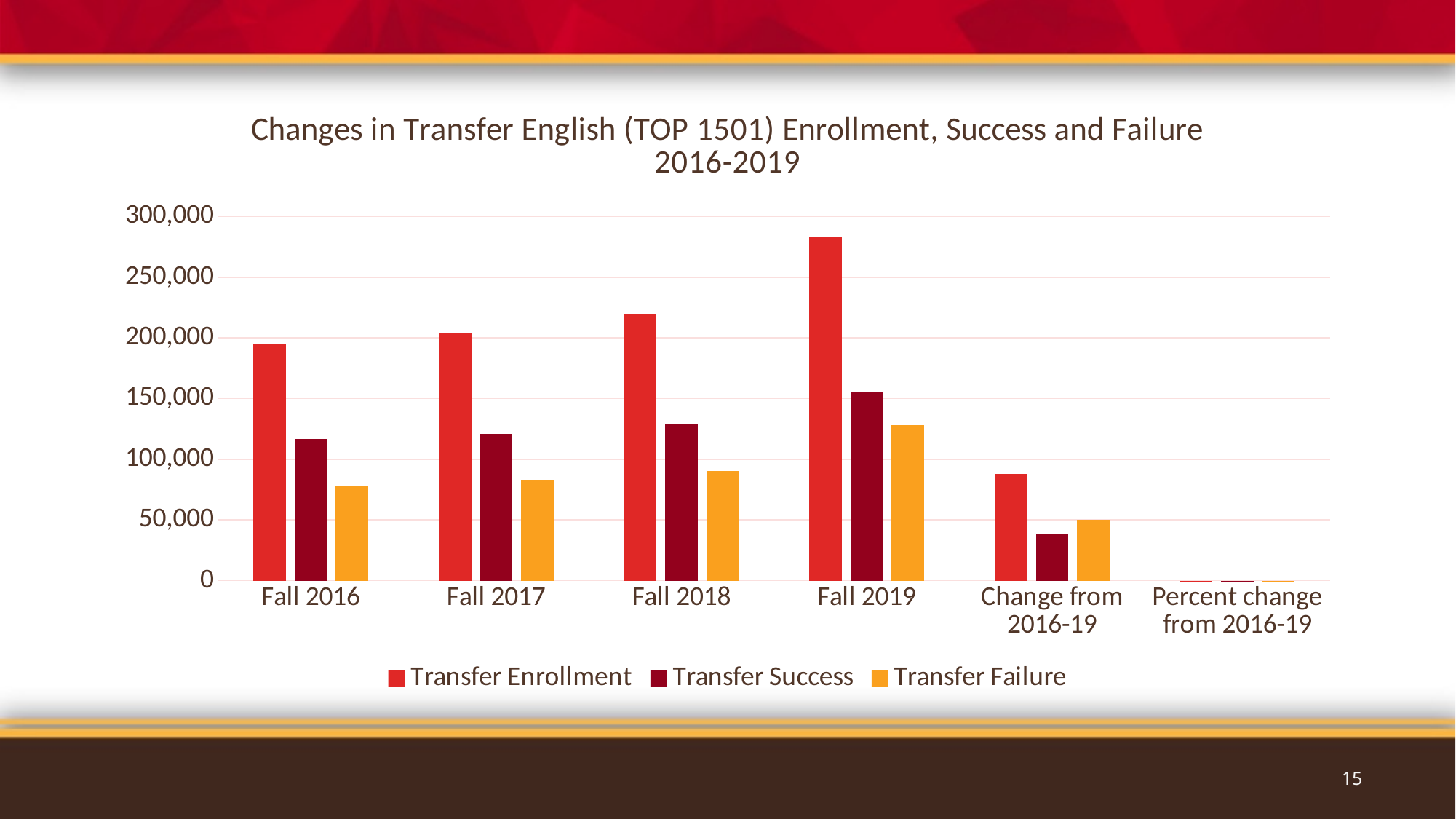
Which is larger: Transfer Failure in Fall 2019 or Transfer Failure in Fall 2016? Fall 2019 Is the Transfer Failure value for Fall 2018 greater or less than 100,000? less Is the Transfer Enrollment value for Fall 2016 greater or less than 200,000? less Is the Transfer Enrollment value for Fall 2019 greater or less than 250,000? greater What kind of chart is shown on the slide? bar chart How many series does the legend list? 3 How many categories are shown along the x axis? 6 In the 'Change from 2016-19' category, which is larger: Transfer Success or Transfer Failure? Transfer Failure What is the title of the chart? Changes in Transfer English (TOP 1501) Enrollment, Success and Failure 2016-2019 In which category is Transfer Enrollment highest? Fall 2019 Among the four Fall terms, in which term is Transfer Failure lowest? Fall 2016 Does Transfer Enrollment rise or fall from Fall 2016 to Fall 2019? rise